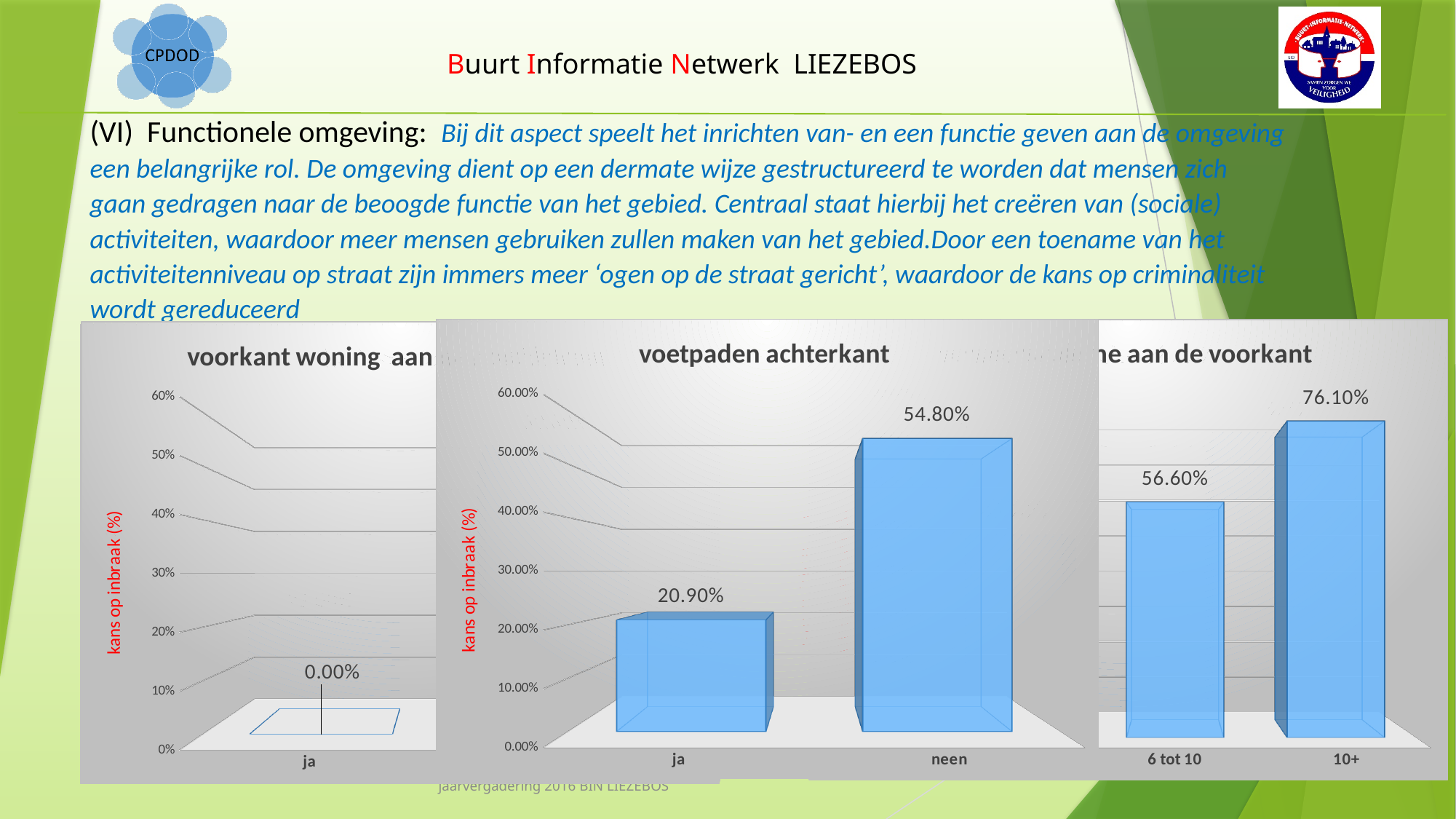
In the 'voetpaden achterkant' chart, what is the value for 'neen'? 54.80% In the chart on the right of the slide, what is the value for '10+'? 76.10% In the 'voetpaden achterkant' chart, how many categories are shown on the x axis? 2 In the 'voetpaden achterkant' chart, what is the label of the y axis? kans op inbraak (%) In the 'voetpaden achterkant' chart, what is the difference between the values for 'neen' and 'ja'? 33.90% In the 'voetpaden achterkant' chart, which category has the highest value? neen In the chart on the right of the slide, which is larger, the value for '6 tot 10' or for '10+'? 10+ In the chart on the left of the slide, what is the value for 'ja'? 0.00% In the chart on the right of the slide, what is the difference between the values for '10+' and '6 tot 10'? 19.50% What kind of chart is the 'voetpaden achterkant' chart? bar chart In the chart on the right of the slide, what is the value for '6 tot 10'? 56.60% In the 'voetpaden achterkant' chart, what is the value for 'ja'? 20.90%